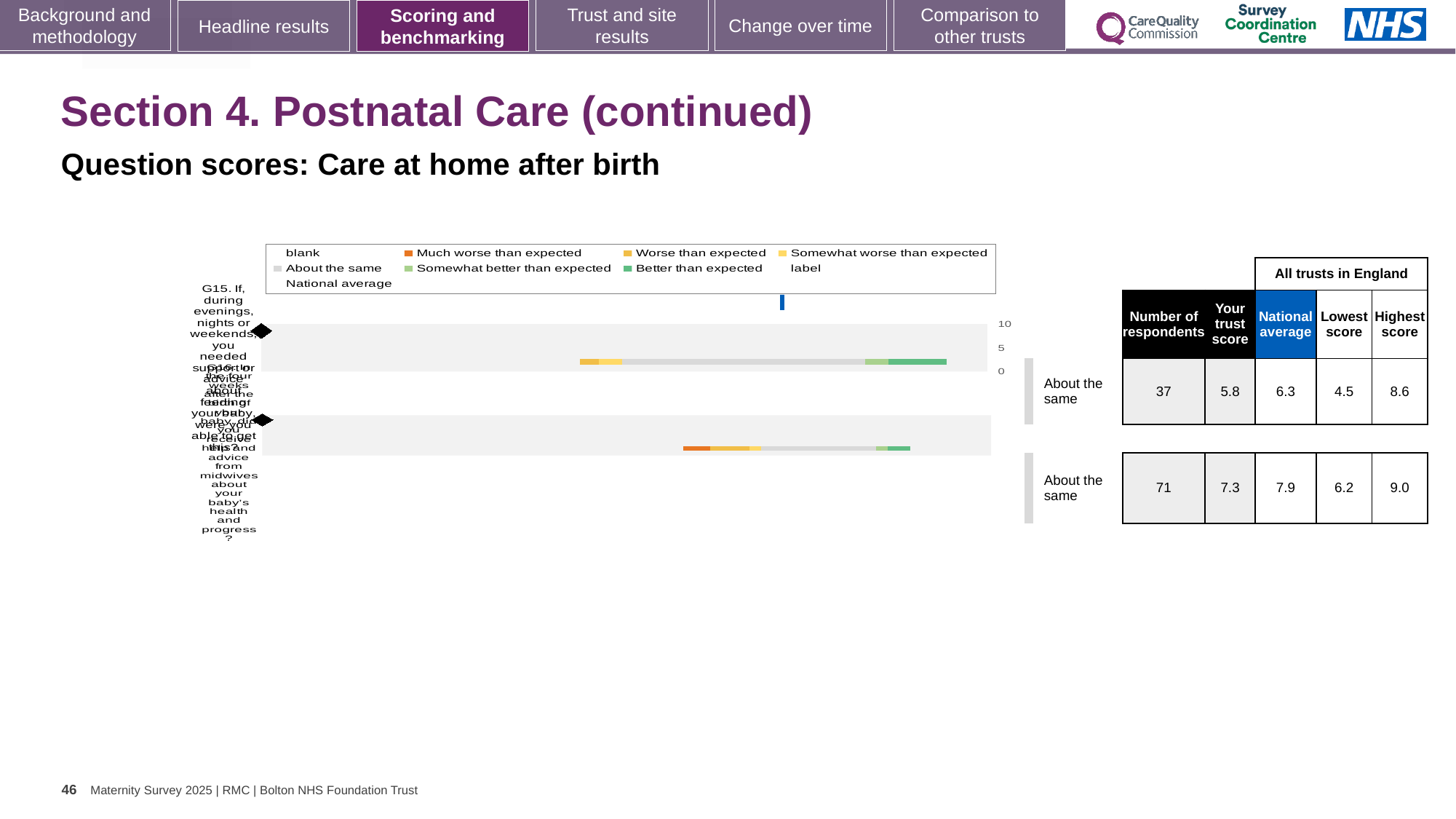
For the second (bottom) question, what is the difference between the highest score and the lowest score? 2.8 In the table next to the chart, what is the national average for the second (bottom) question? 7.9 What kind of chart is shown on the slide? bar chart Which question has more respondents, the first (top) or the second (bottom)? the second (bottom) question In the table next to the chart, what is the number of respondents for the first (top) question? 37 In the table next to the chart, what is the highest score for the second (bottom) question? 9.0 For the first (top) question, what is the difference between the national average and the trust score? 0.5 In the table next to the chart, what is the trust score for the first (top) question? 5.8 How many questions (bars) are plotted in the chart? 2 In the table next to the chart, what is the lowest score for the first (top) question? 4.5 What benchmark category is shown for both questions in the chart? About the same What is the highest value shown on the chart's axis? 10